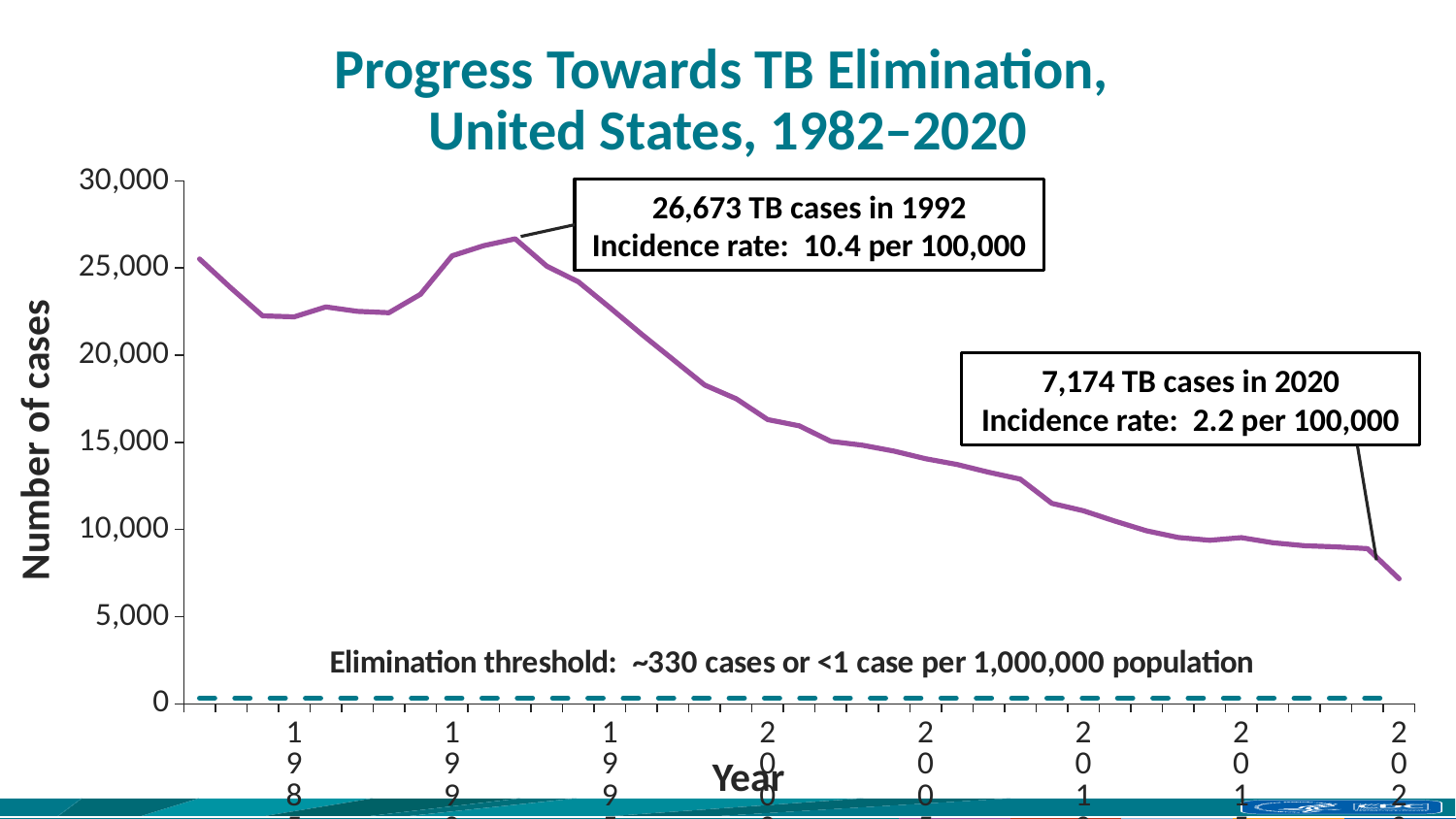
How many TB cases were reported in 2020 according to the annotation? 7,174 Is the number of TB cases in 2000 greater or less than 20,000? less In which annotated year does the line reach its peak? 1992 What is the difference between the number of TB cases in 1992 and in 2020? 19,499 What was the TB incidence rate in 2020? 2.2 per 100,000 Which year had more TB cases, 1992 or 2020? 1992 What is the elimination threshold stated on the chart? ~330 cases or <1 case per 1,000,000 population What was the TB incidence rate in 1992? 10.4 per 100,000 What is the label of the y-axis? Number of cases How many TB cases were reported in 1992 according to the annotation? 26,673 Do the number of TB cases rise or fall from 1992 to 2020? fall What kind of chart is shown on the slide? line chart